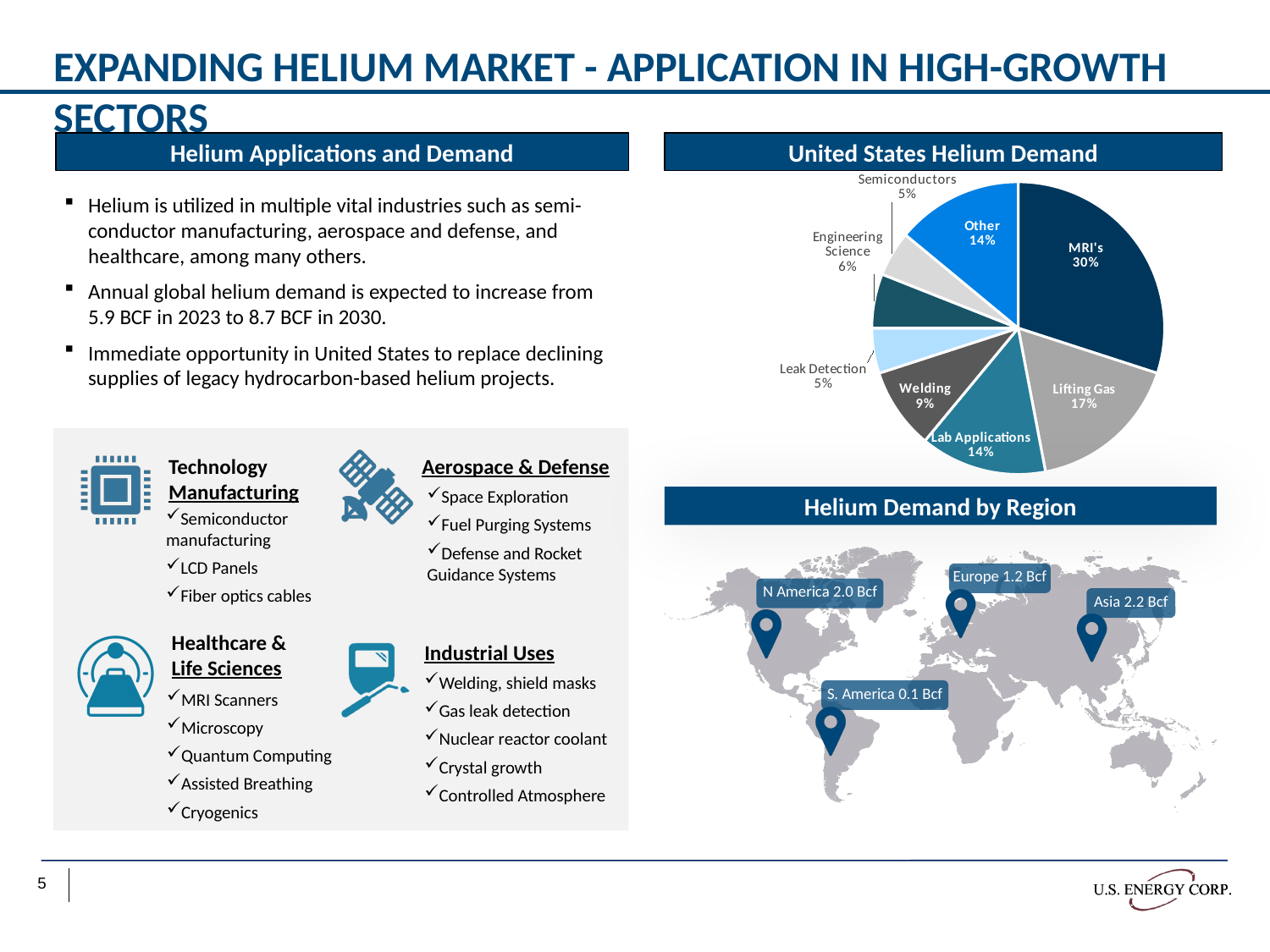
In the United States Helium Demand pie chart, what percentage is shown for Lifting Gas? 17% In the United States Helium Demand pie chart, what is the difference in percentage points between MRI's and Lifting Gas? 13 percentage points What type of chart is used to show United States Helium Demand? Pie chart In the United States Helium Demand pie chart, which is larger, Engineering Science or Leak Detection? Engineering Science In the United States Helium Demand pie chart, what percentage is shown for Engineering Science? 6% In the United States Helium Demand pie chart, what share of the pie do Lab Applications represent? 14% In the United States Helium Demand pie chart, which is larger, Lifting Gas or Lab Applications? Lifting Gas In the United States Helium Demand pie chart, which category has the largest share? MRI's In the United States Helium Demand pie chart, what percentage is shown for Welding? 9% In the United States Helium Demand pie chart, what share of demand is attributed to MRI's? 30% What is the title of the pie chart on the slide? United States Helium Demand How many slices does the United States Helium Demand pie chart have? 8